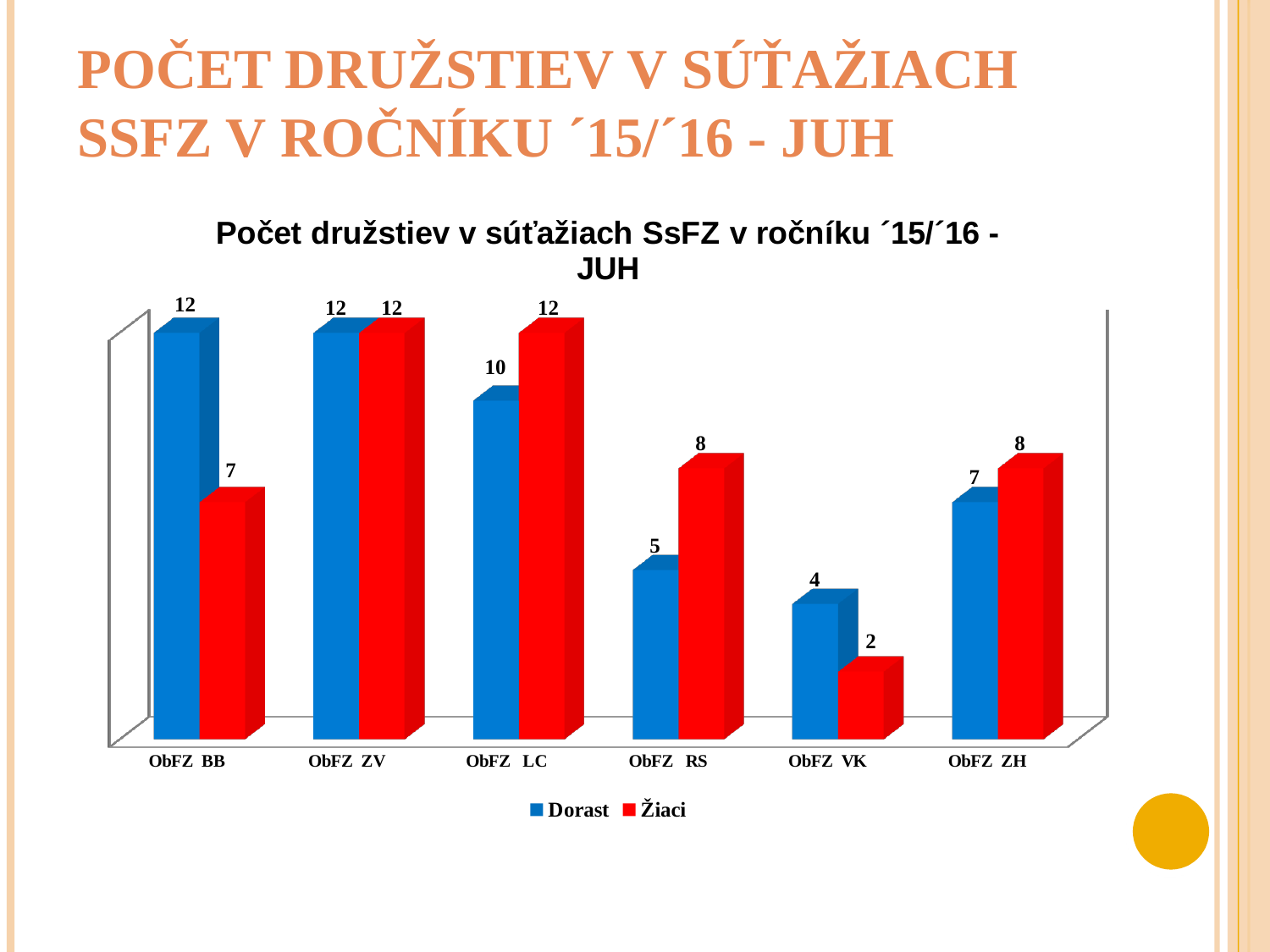
What is the difference between the Dorast and Žiaci values for ObFZ BB? 5 Which is larger for ObFZ LC, the Dorast value or the Žiaci value? Žiaci Which colour represents the Žiaci series? red Which category has the lowest Žiaci value? ObFZ VK What is the Žiaci value for ObFZ LC? 12 Which category has the lowest Dorast value? ObFZ VK How many categories are shown on the x axis? 6 What kind of chart is shown on the slide? bar chart What is the Dorast value for ObFZ BB? 12 How many series does the legend list? 2 What is the difference between the Žiaci values for ObFZ RS and ObFZ VK? 6 What is the Žiaci value for ObFZ VK? 2